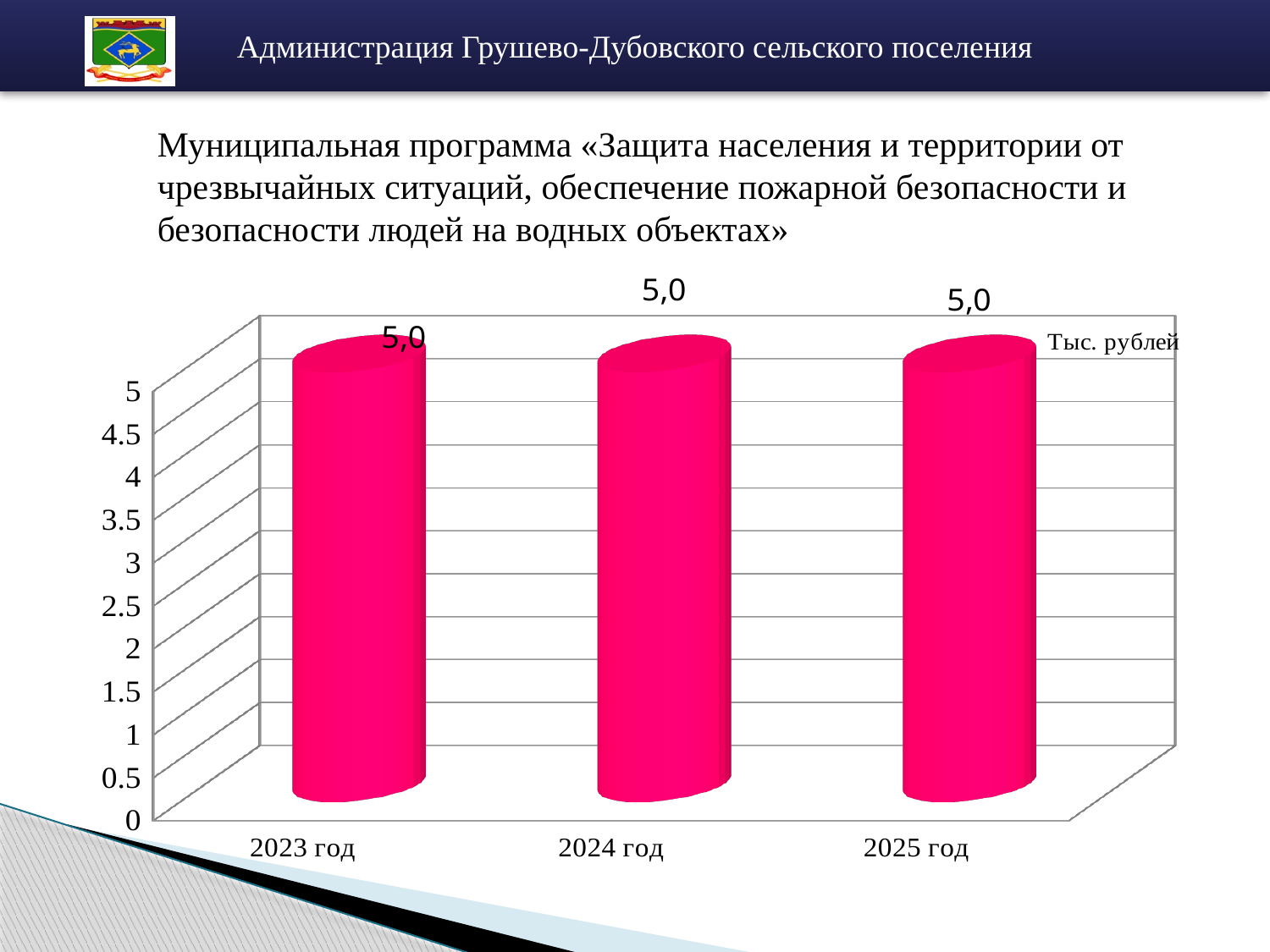
What kind of chart is shown on the slide? Bar chart Is the value for 2025 год greater or less than 4? greater What is the value for 2025 год? 5,0 What is the value for 2023 год? 5,0 What is the total of the values for 2023 год, 2024 год and 2025 год? 15,0 Do the values rise, fall or stay the same from 2023 год to 2025 год? Stay the same What unit is indicated on the chart? Тыс. рублей What is the difference between the values for 2024 год and 2023 год? 0,0 How many categories (years) are shown on the chart? 3 Is the value for 2023 год greater or less than 3? greater What colour are the bars on the chart? Pink What is the value for 2024 год? 5,0